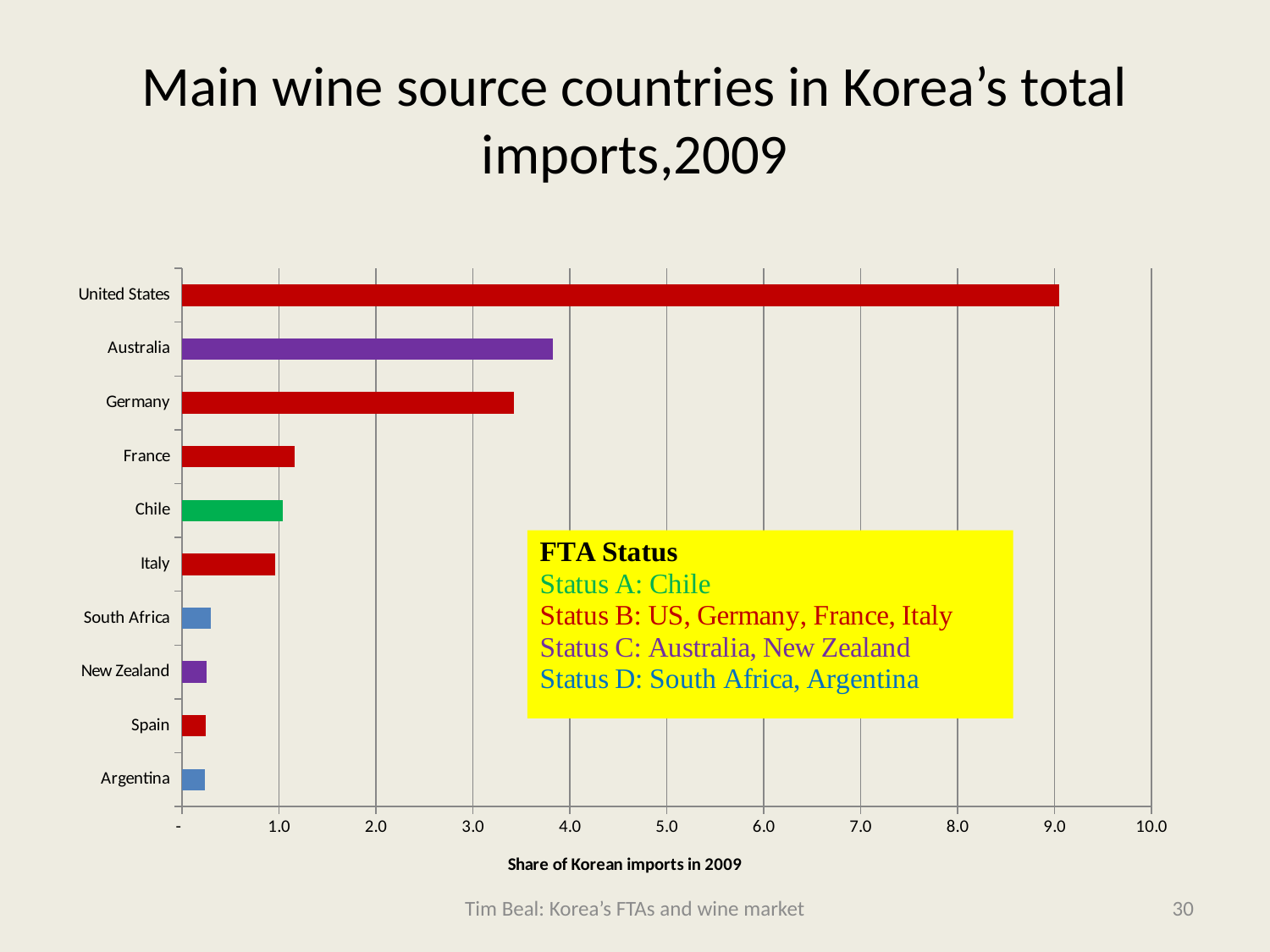
Is the value for Germany greater or less than 3.0? greater Which country has the highest share of Korean wine imports in 2009? United States What kind of chart is shown on the slide? bar chart Is the value for Australia greater or less than 4.0? less Is the value for United States greater or less than 8.0? greater What is the title of the horizontal axis? Share of Korean imports in 2009 How many countries are shown in the chart? 10 Which has a larger share, Germany or France? Germany What colour is the bar for Chile? green Which has a larger share, United States or Australia? United States